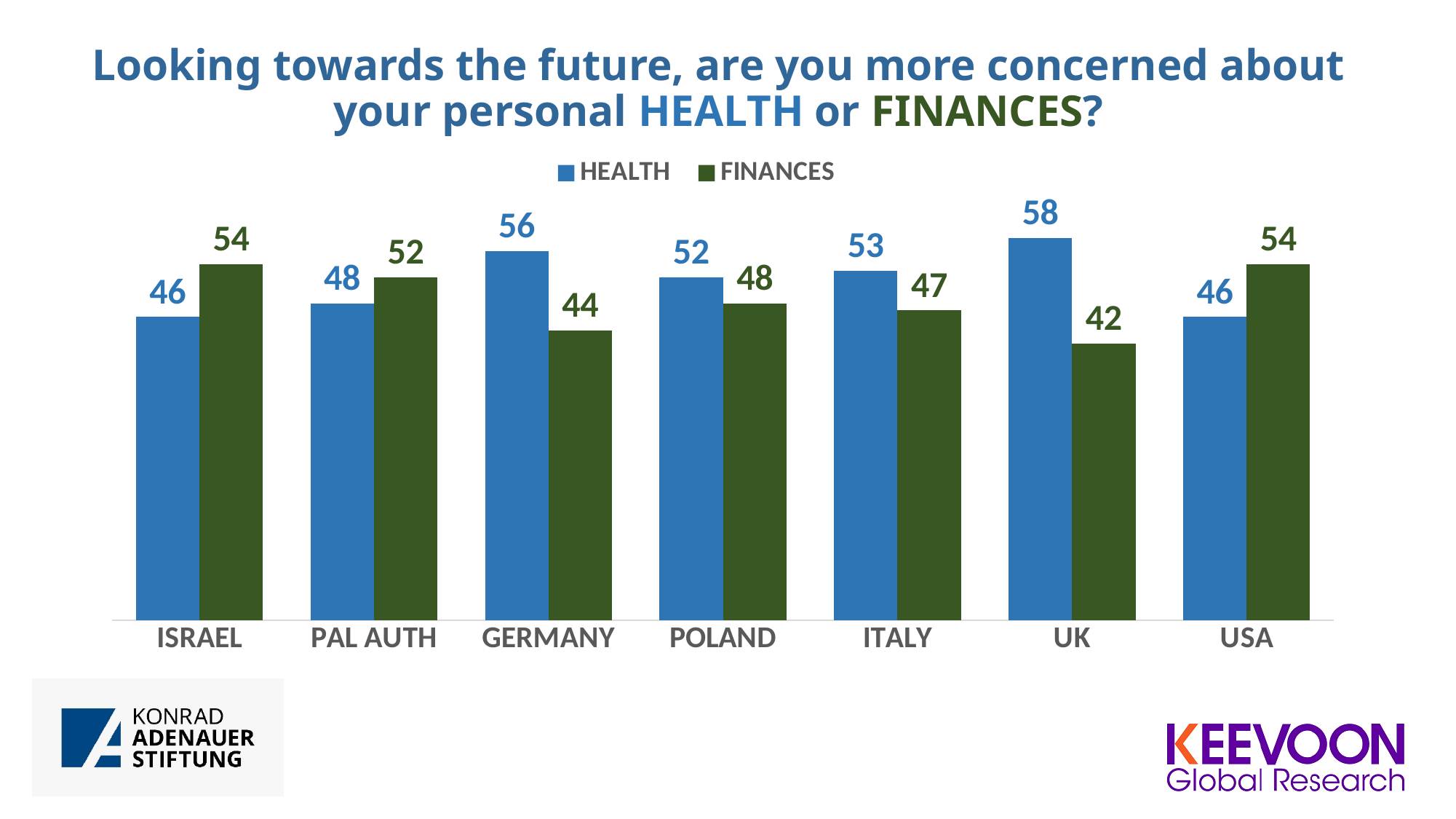
Which country has the highest HEALTH value? UK Which country has the lowest FINANCES value? UK For Poland, which is larger, the HEALTH value or the FINANCES value? HEALTH What is the difference between the FINANCES values for Israel and Germany? 10 What is the difference between the HEALTH and FINANCES values for the UK? 16 What is the HEALTH value for Germany? 56 What is the FINANCES value for the UK? 42 How many series does the legend list? 2 How many countries are shown on the x axis? 7 What kind of chart is shown on the slide? Bar chart What is the FINANCES value for Israel? 54 Which colour represents FINANCES in the chart? Green